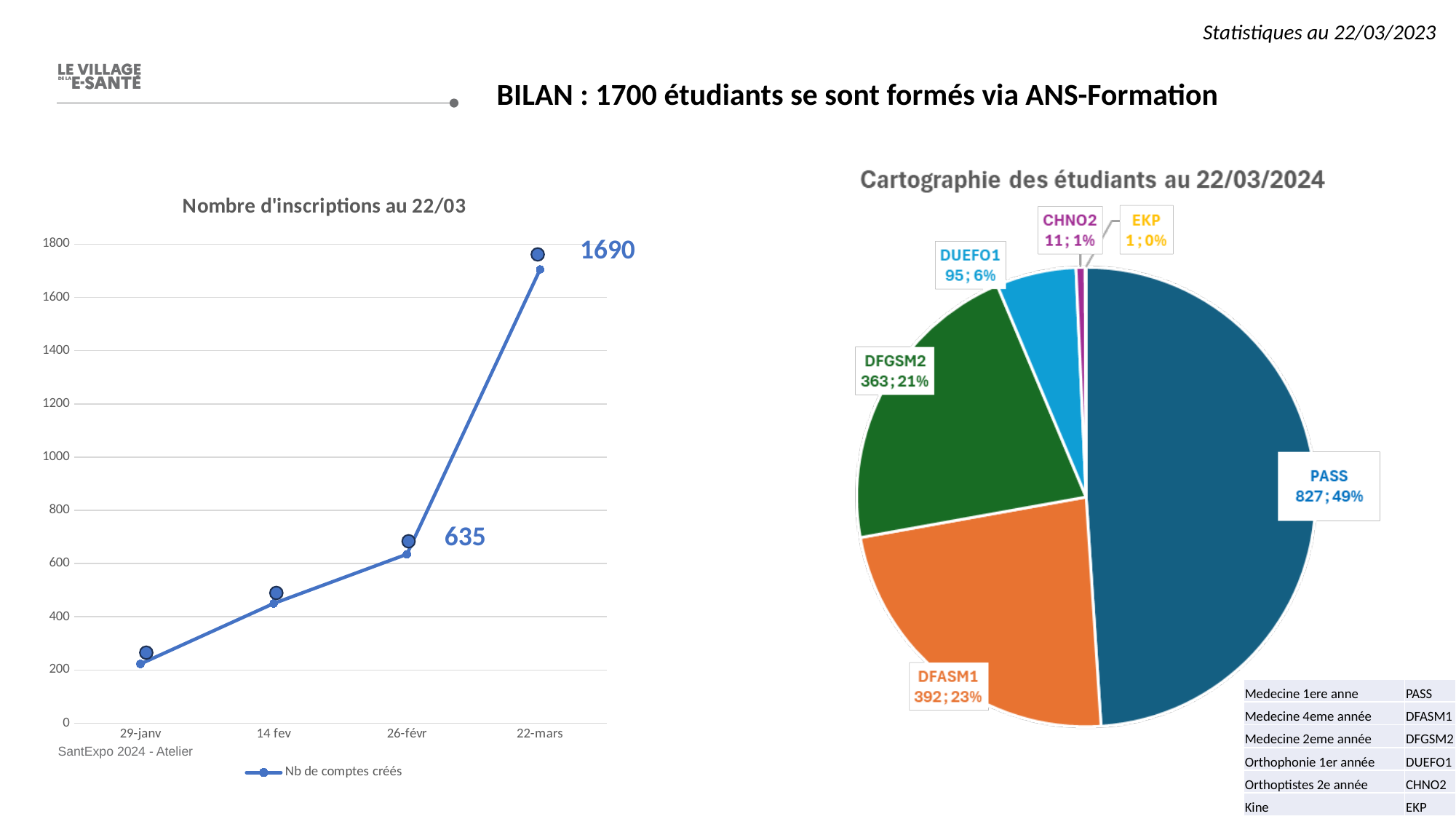
What kind of chart is 'Nombre d'inscriptions au 22/03'? line chart In the chart 'Cartographie des étudiants au 22/03/2024', what is the value for PASS? 827 In the chart 'Cartographie des étudiants au 22/03/2024', which category has the smallest slice? EKP In the chart 'Nombre d'inscriptions au 22/03', what is the difference between the values for 22-mars and 26-févr? 1055 In the chart 'Nombre d'inscriptions au 22/03', do the values rise or fall from 29-janv to 22-mars? rise In the chart 'Nombre d'inscriptions au 22/03', what series name does the legend show? Nb de comptes créés In the chart 'Nombre d'inscriptions au 22/03', is the value for 29-janv greater or less than 400? less In the chart 'Cartographie des étudiants au 22/03/2024', how many slices does the pie have? 6 In the chart 'Nombre d'inscriptions au 22/03', what is the value for 26-févr? 635 In the chart 'Cartographie des étudiants au 22/03/2024', which is larger, DFGSM2 or DUEFO1? DFGSM2 In the chart 'Cartographie des étudiants au 22/03/2024', what share of the pie does DFASM1 represent? 23% In the chart 'Nombre d'inscriptions au 22/03', what is the value for 22-mars? 1690